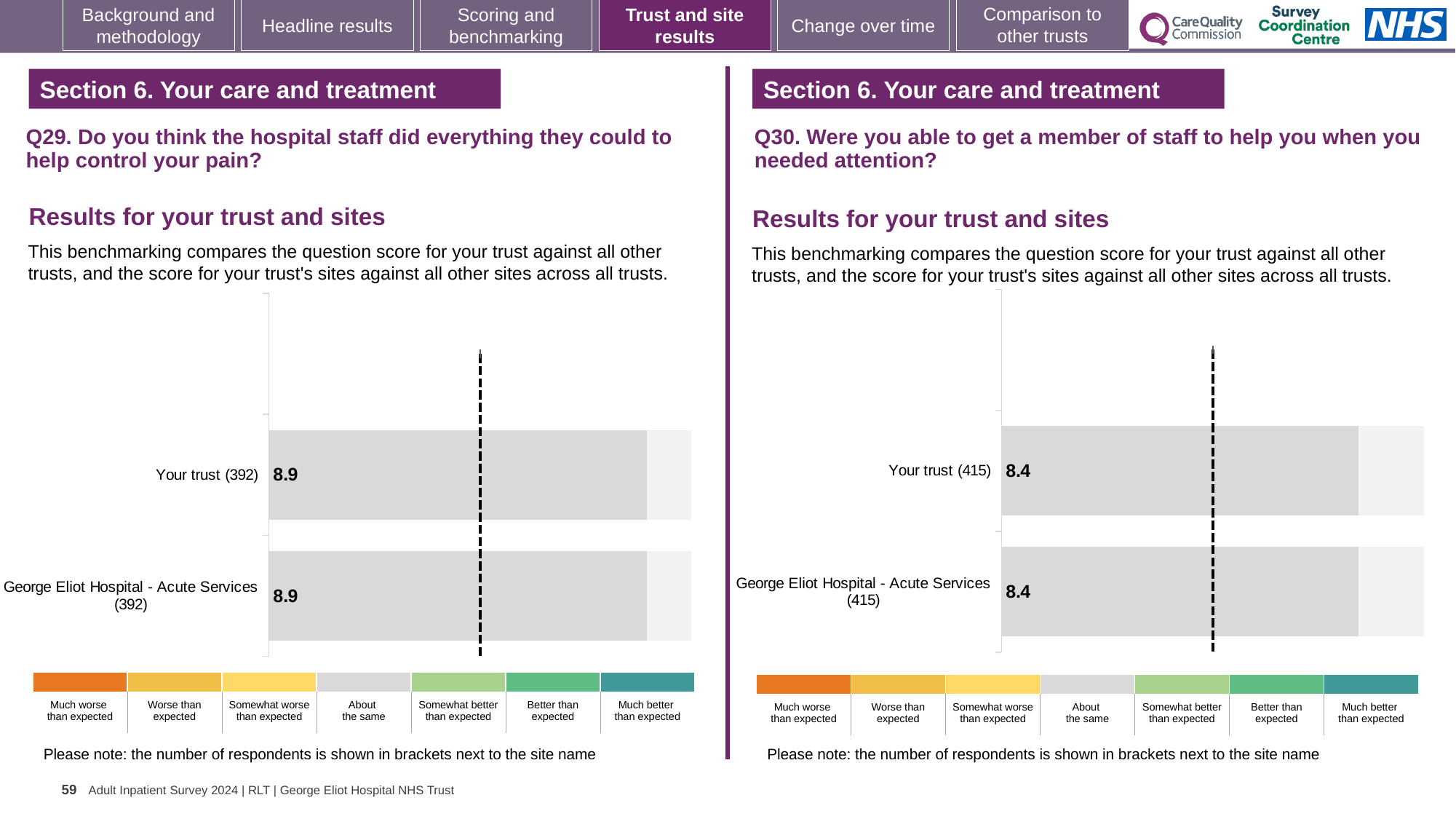
On the Q29 chart (left), what is the score for Your trust? 8.9 On the Q29 chart (left), how many respondents are shown in brackets next to Your trust? 392 On the Q30 chart (right), what is the score for Your trust? 8.4 On the Q29 chart (left), what is the score for George Eliot Hospital - Acute Services? 8.9 On the Q30 chart (right), what is the score for George Eliot Hospital - Acute Services? 8.4 On the Q30 chart (right), what is the difference between the score for Your trust and the score for George Eliot Hospital - Acute Services? 0 How many bars are plotted on the Q30 chart (right)? 2 On the Q29 chart (left), what is the difference between the score for Your trust and the score for George Eliot Hospital - Acute Services? 0 On the Q30 chart (right), how many respondents are shown in brackets next to George Eliot Hospital - Acute Services? 415 What kind of chart is used on the Q30 chart (right)? Bar chart Is the score for Your trust on the Q29 chart (left) larger or smaller than the score for Your trust on the Q30 chart (right)? Larger How many bars are plotted on the Q29 chart (left)? 2